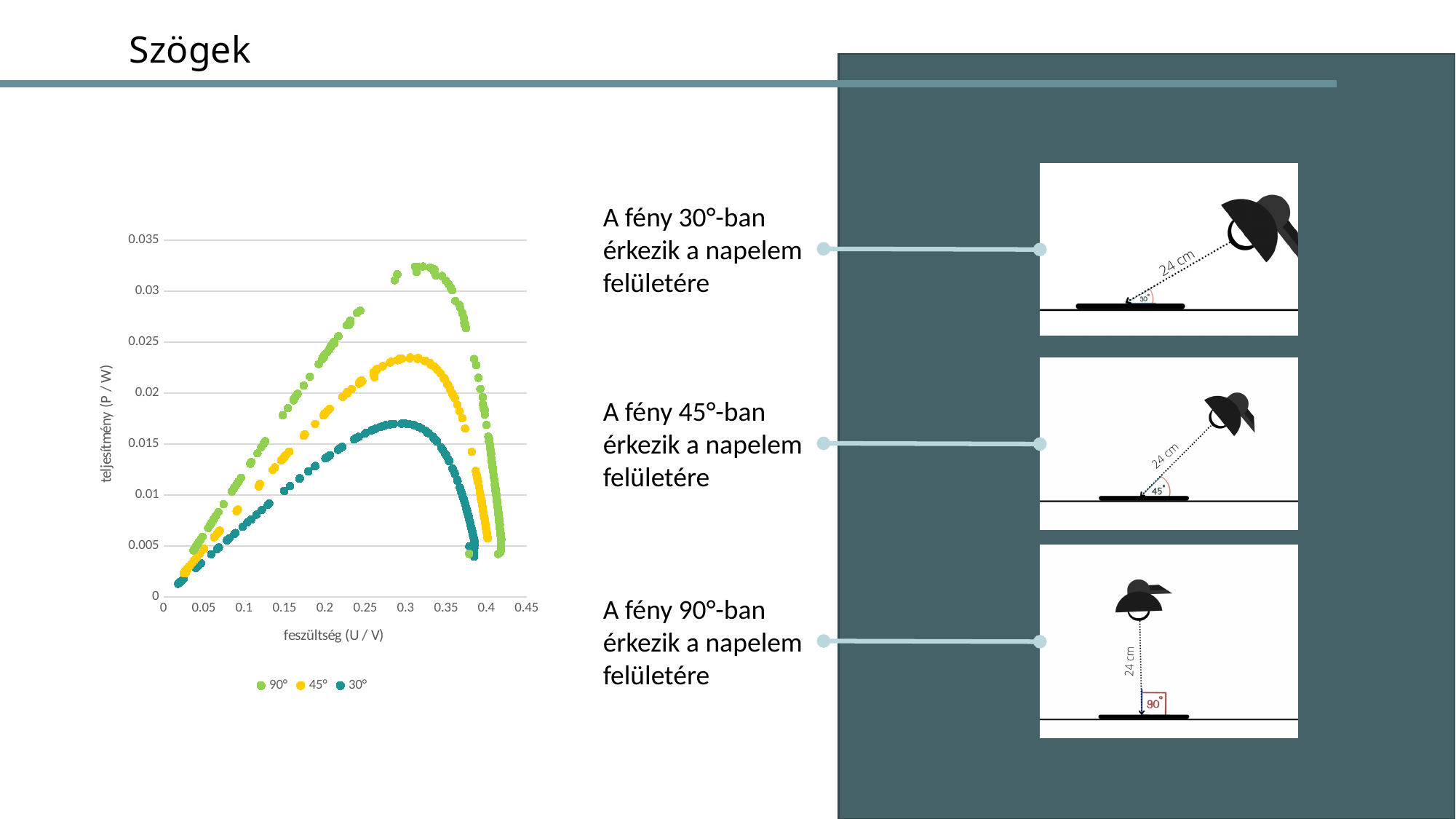
Which series reaches the highest power (teljesítmény) value in the chart? 90° Is the peak value of the 30° series greater or less than 0.015? greater Which series reaches the lowest peak power value in the chart? 30° What are the three series named in the chart legend? 90°, 45°, 30° Is the maximum value shown on the chart's y axis greater or less than 0.03? greater Which series has the higher peak power, 45° or 30°? 45° What kind of chart is shown on the slide? scatter chart How does the power of the 90° series change as voltage increases along the x axis? rises to a peak, then falls Is the peak value of the 45° series greater or less than 0.025? less How many series does the chart legend list? 3 What is the title of the chart's x axis? feszültség (U / V)